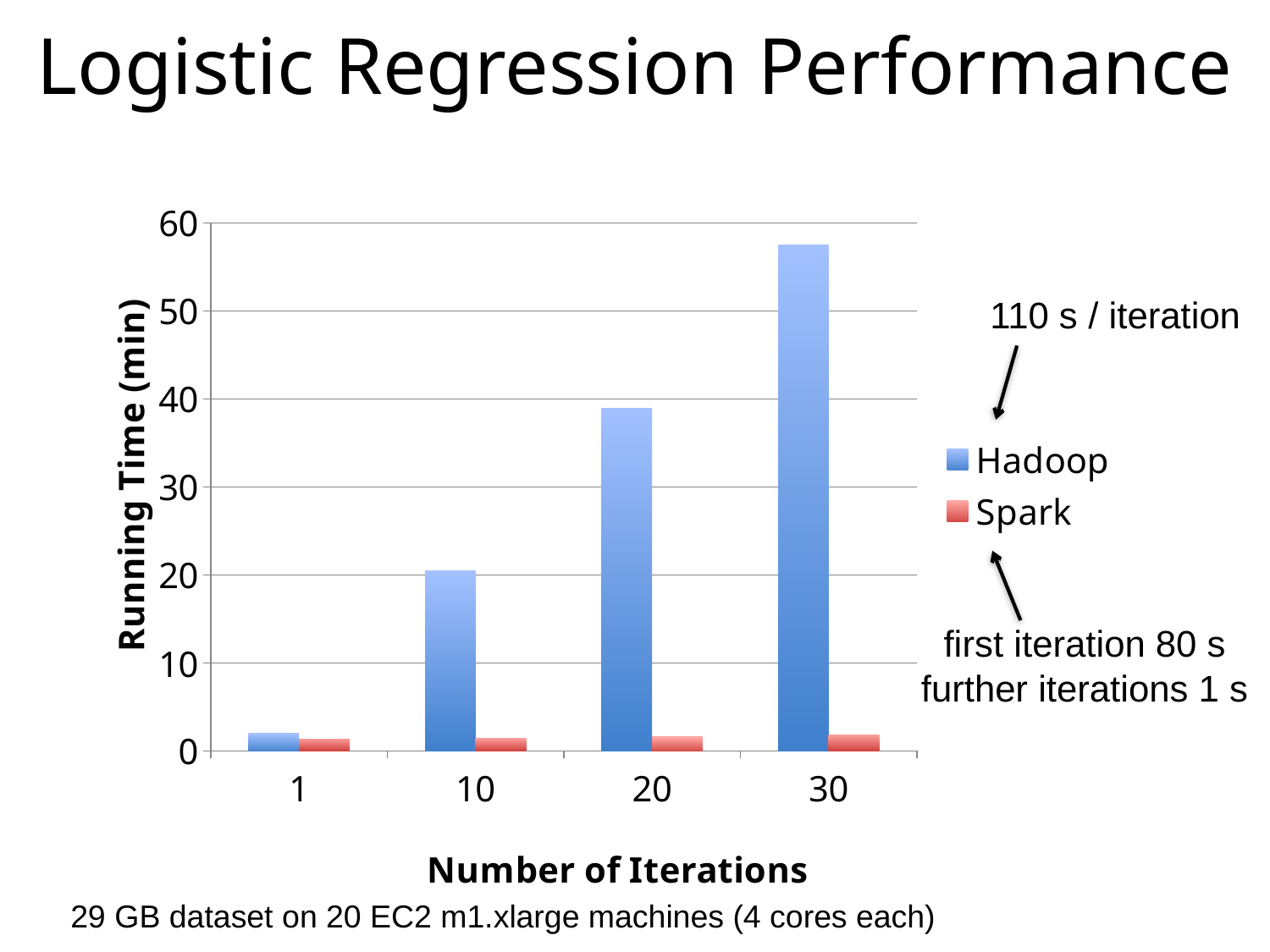
Is the Hadoop running time at 30 iterations greater or less than 50 minutes? greater What is the label of the y axis? Running Time (min) How many iteration counts are shown on the x axis? 4 Does the Hadoop running time rise or fall as the number of iterations increases? rise Which colour represents Spark in the legend? red At which number of iterations is the Hadoop running time highest? 30 At which number of iterations is the Hadoop running time lowest? 1 How many series does the legend list? 2 What kind of chart is shown on the slide? bar chart Is the Hadoop running time at 20 iterations greater or less than 30 minutes? greater At 30 iterations, which has the larger running time, Hadoop or Spark? Hadoop Is the Spark running time at 30 iterations greater or less than 10 minutes? less